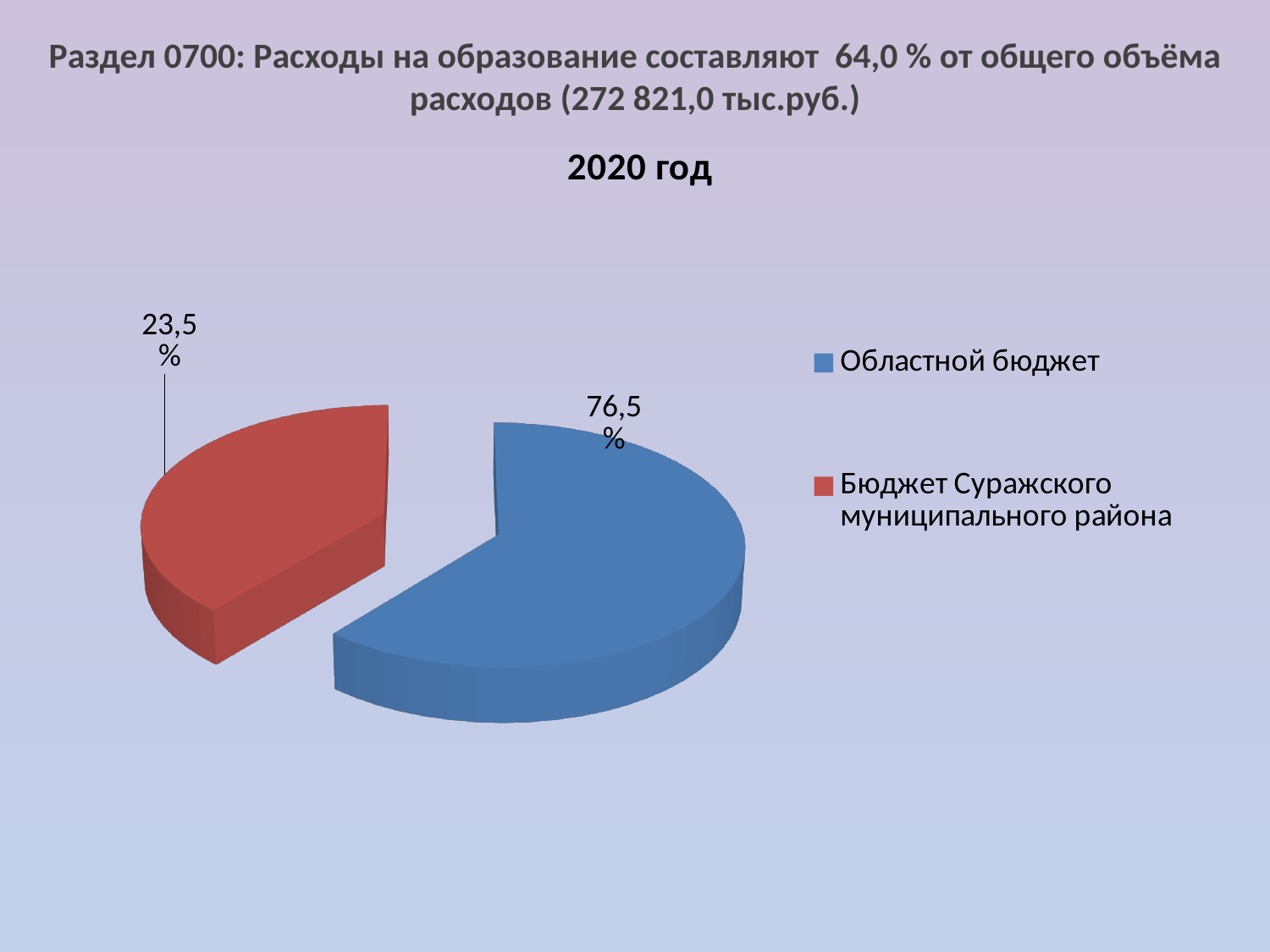
What share of the pie does Бюджет Суражского муниципального района have? 23,5 % What colour is the slice for Бюджет Суражского муниципального района? Red Which category has the largest slice of the pie? Областной бюджет How many slices does the pie chart have? 2 What share of the pie does Областной бюджет have? 76,5 % Which is larger: the Областной бюджет slice or the Бюджет Суражского муниципального района slice? Областной бюджет Which category has the smallest slice of the pie? Бюджет Суражского муниципального района What year does the chart title refer to? 2020 год What kind of chart is shown on the slide? Pie chart How many entries does the legend list? 2 What is the difference in percentage points between the Областной бюджет slice and the Бюджет Суражского муниципального района slice? 53 percentage points